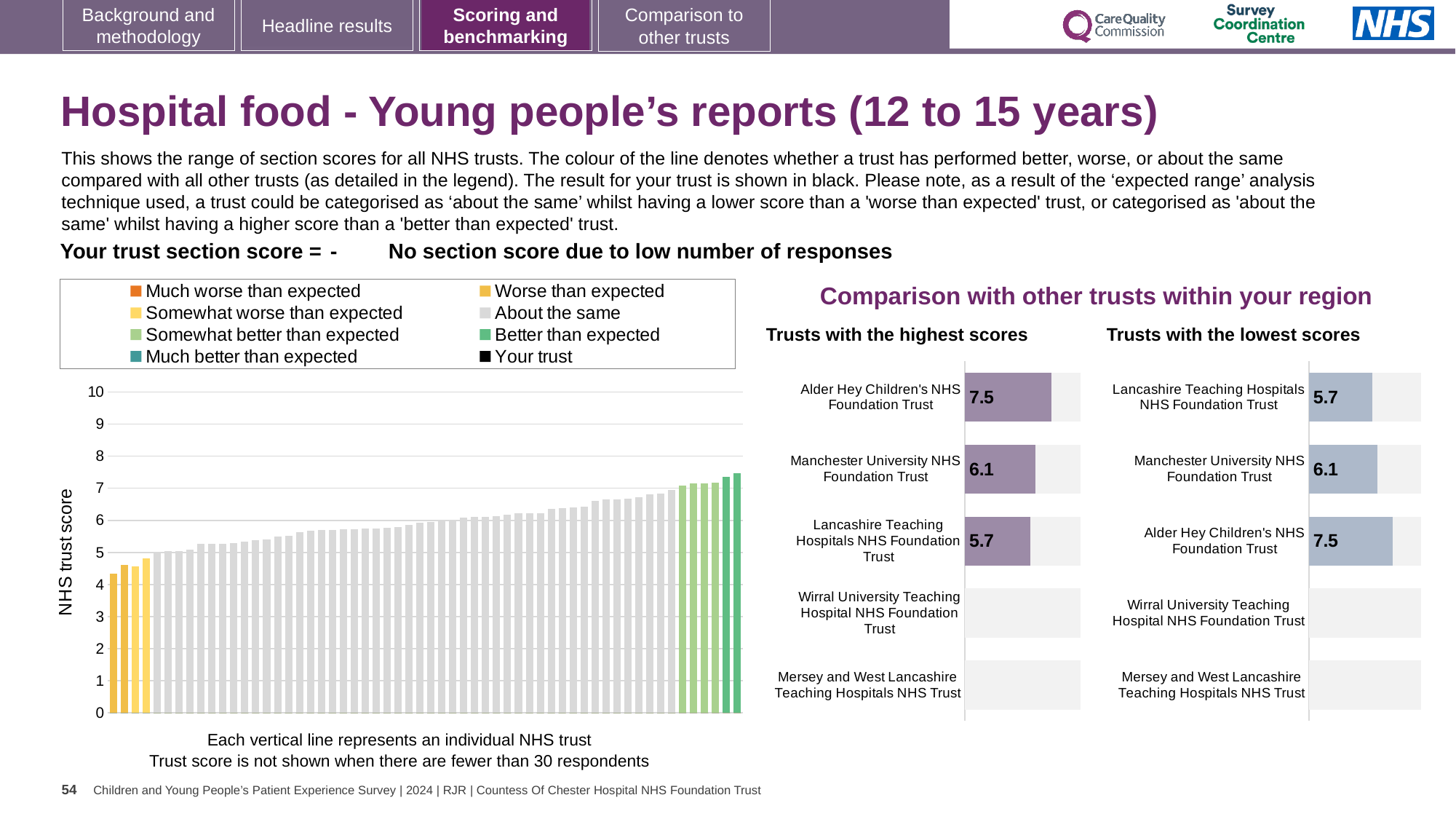
In the 'Trusts with the lowest scores' chart, what is the score for Lancashire Teaching Hospitals NHS Foundation Trust? 5.7 In the main 'NHS trust score' chart, is the value of the tallest bar greater or less than 7? greater What kind of chart is the main 'NHS trust score' chart on the left? Bar chart In the 'Trusts with the highest scores' chart, what is the difference between the scores of Alder Hey Children's NHS Foundation Trust and Lancashire Teaching Hospitals NHS Foundation Trust? 1.8 In the 'Trusts with the highest scores' chart, what is the score for Alder Hey Children's NHS Foundation Trust? 7.5 In the 'Trusts with the lowest scores' chart, which has the larger score: Manchester University NHS Foundation Trust or Lancashire Teaching Hospitals NHS Foundation Trust? Manchester University NHS Foundation Trust In the main 'NHS trust score' chart, do the bar values rise or fall from left to right? Rise How many trusts are listed in the 'Trusts with the highest scores' chart? 5 In the 'Trusts with the highest scores' chart, what is the score for Manchester University NHS Foundation Trust? 6.1 In the 'Trusts with the lowest scores' chart, which trust has the lowest score? Lancashire Teaching Hospitals NHS Foundation Trust In the 'Trusts with the highest scores' chart, which trust has the highest score? Alder Hey Children's NHS Foundation Trust How many entries does the legend of the main 'NHS trust score' chart list? 8